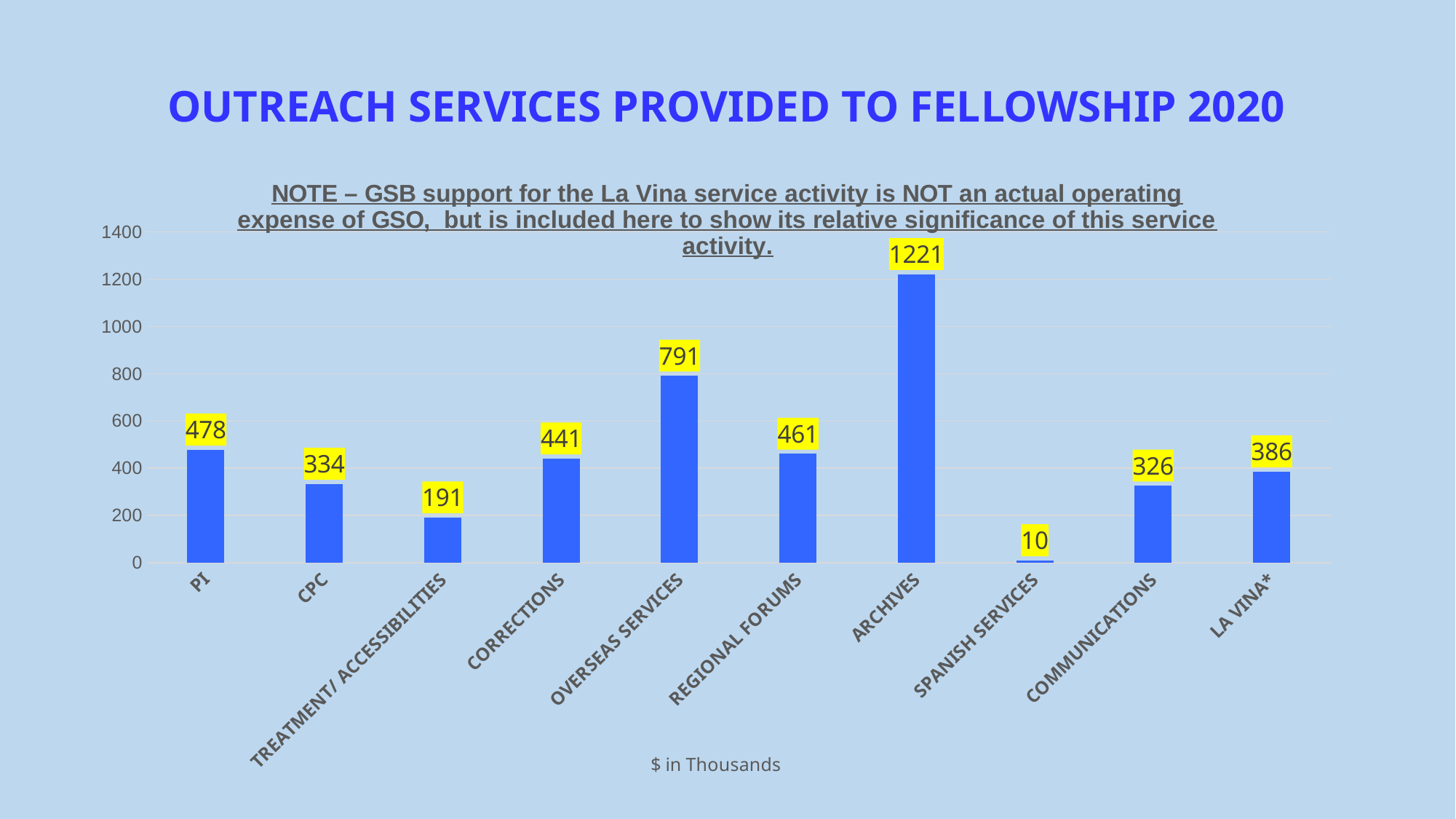
What is the value for SPANISH SERVICES? 10 What is the difference between the values for ARCHIVES and OVERSEAS SERVICES? 430 What kind of chart is shown on the slide? Bar chart What is the value for LA VINA*? 386 Which is larger, the value for PI or the value for REGIONAL FORUMS? PI Is the value for CORRECTIONS greater or less than 400? greater What unit is stated below the x axis? $ in Thousands Which category has the highest value? ARCHIVES What is the value for ARCHIVES? 1221 What is the value for OVERSEAS SERVICES? 791 How many categories are shown on the x axis? 10 Which category has the lowest value? SPANISH SERVICES